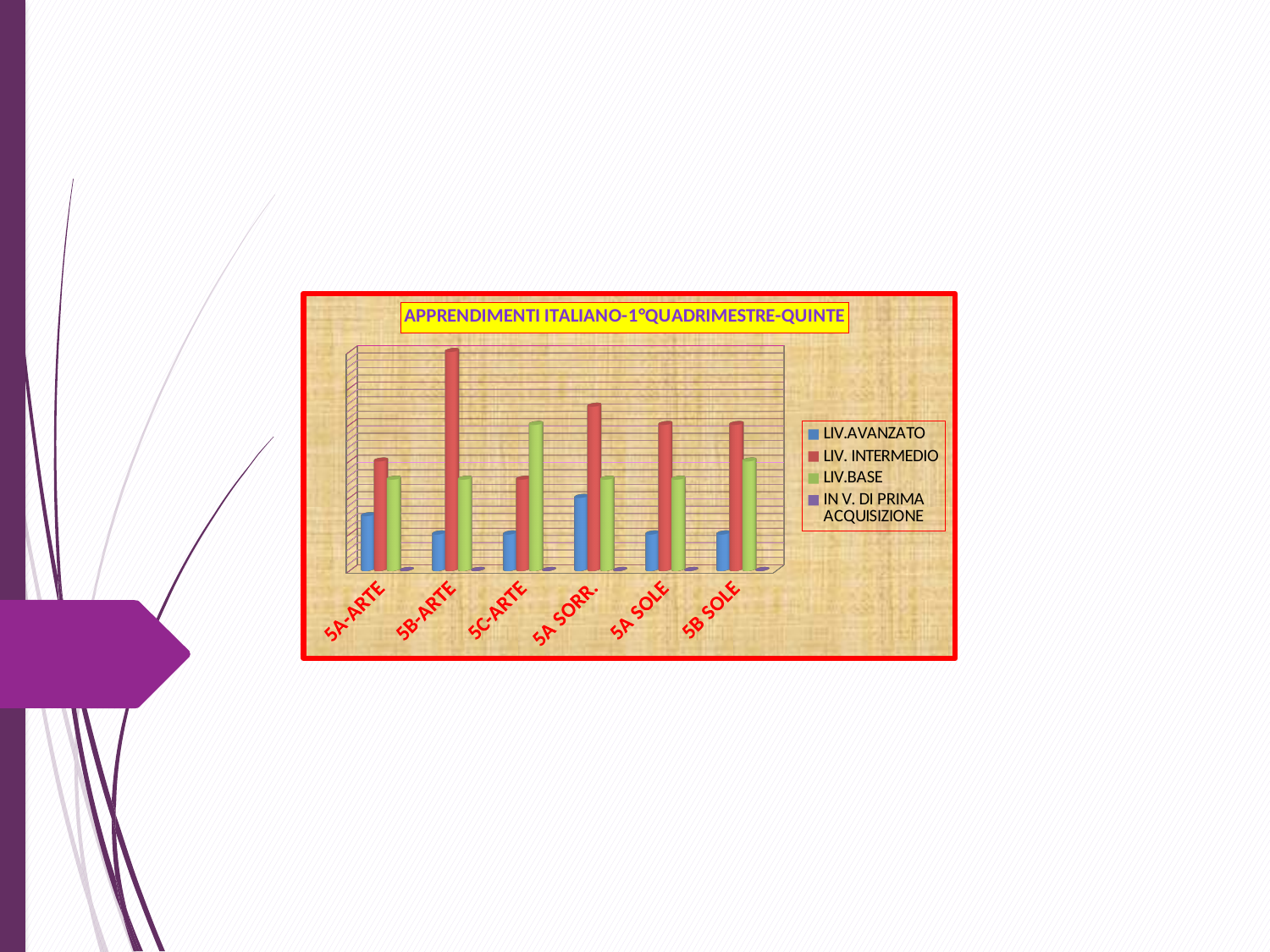
How many classes (categories) are shown on the x axis? 6 Which class has the highest LIV.BASE bar? 5C-ARTE What is the title of the chart? APPRENDIMENTI ITALIANO-1°QUADRIMESTRE-QUINTE Which class has the highest LIV. INTERMEDIO bar? 5B-ARTE Which series has the tallest bar for 5A-ARTE? LIV. INTERMEDIO For 5C-ARTE, which is larger: LIV. INTERMEDIO or LIV.BASE? LIV.BASE How many series does the legend list? 4 What kind of chart is shown on the slide? Bar chart For 5B-ARTE, which is larger: LIV. INTERMEDIO or LIV.BASE? LIV. INTERMEDIO Which series is shown in red in the legend? LIV. INTERMEDIO Which is larger: the LIV.AVANZATO bar for 5A SORR. or the LIV.AVANZATO bar for 5B-ARTE? 5A SORR.